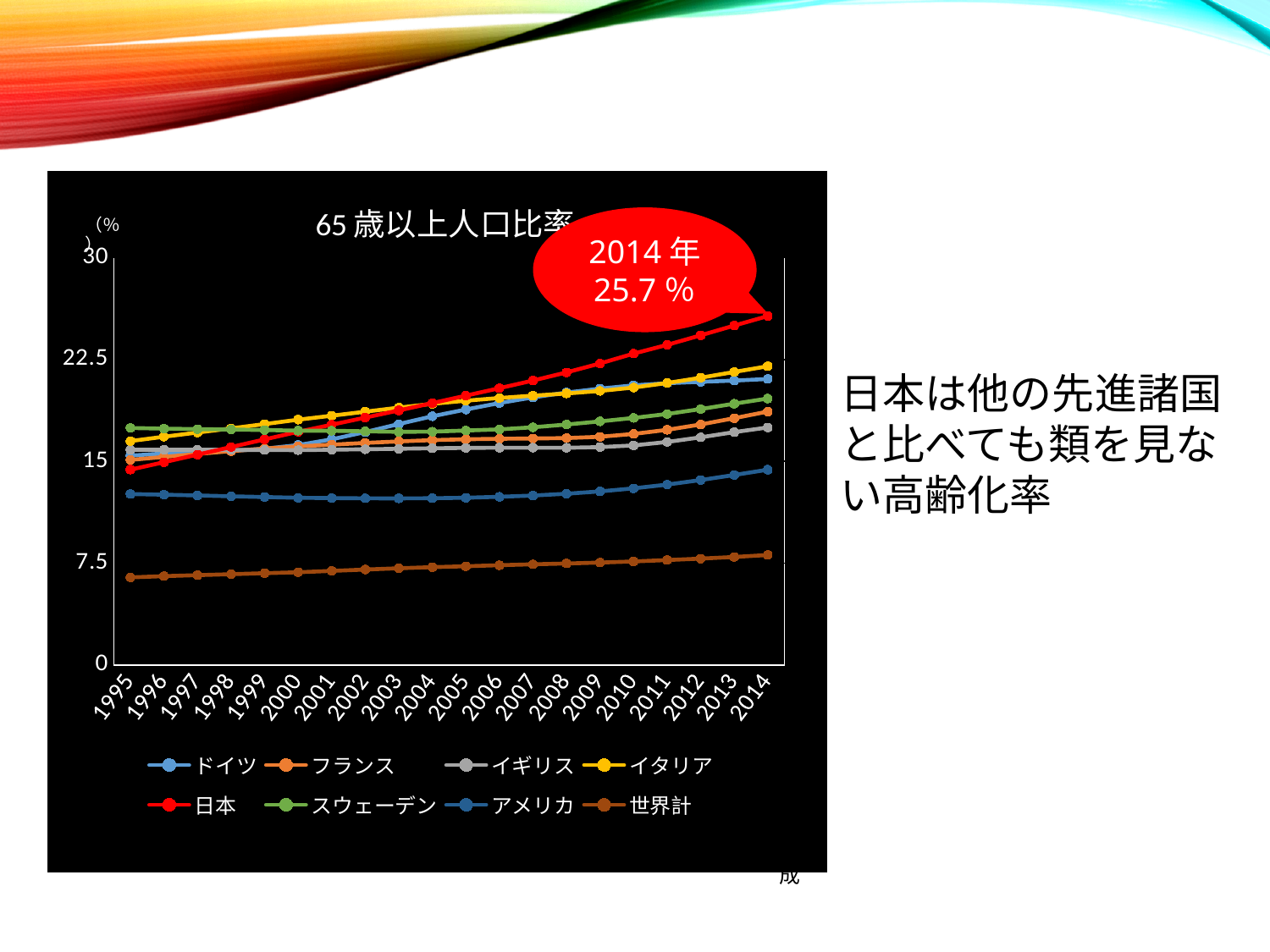
What is the value for 日本 in 2014, as shown in the callout? 25.7 % What is the title of the chart? 65 歳以上人口比率 Which series has the highest value in 2014? 日本 How many years are plotted along the x axis? 20 What kind of chart is shown on the slide? line chart In 2014, which is larger: the value for アメリカ or the value for 世界計? アメリカ Which series has the lowest value in 2014? 世界計 Does the value for 日本 rise or fall from 1995 to 2014? rise In 2014, which is larger: the value for 日本 or the value for イタリア? 日本 How many series does the legend list? 8 Is the value for 世界計 in 2014 greater or less than 15? less Is the value for 日本 in 2014 greater or less than 22.5? greater